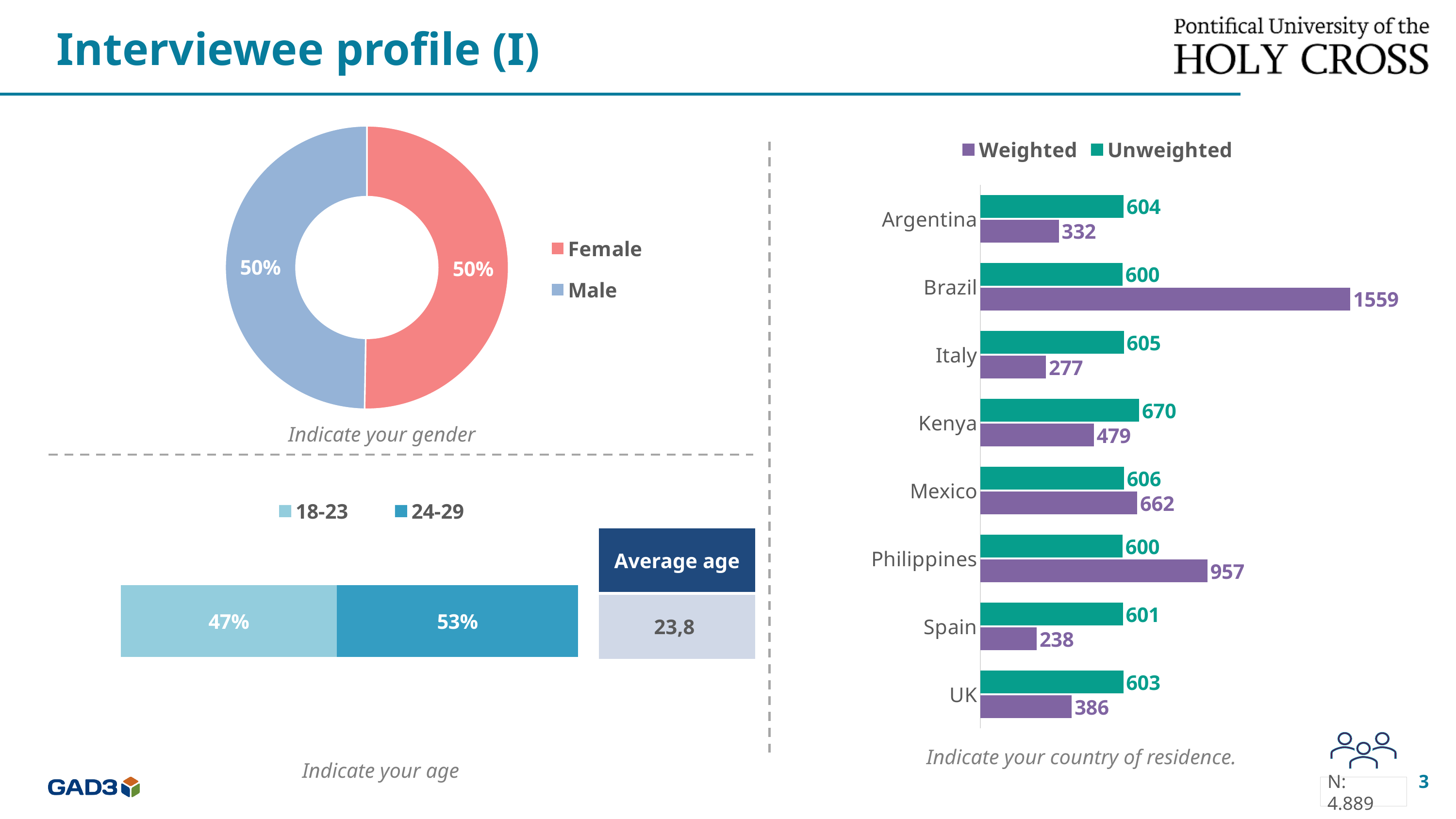
In the 'Indicate your age' chart, what is the total of the two age groups in the stacked bar? 100% In the 'Indicate your age' chart, what is the value for the 24-29 group? 53% In the country of residence chart, is the Weighted value for Mexico larger or smaller than its Unweighted value? larger In the country of residence chart, what is the Weighted value for Brazil? 1559 In the country of residence chart, how many series does the legend list? 2 In the country of residence chart, what is the difference between the Unweighted and Weighted values for Argentina? 272 In the country of residence chart, which country has the lowest Weighted value? Spain In the 'Indicate your gender' chart, what share is Female? 50% In the country of residence chart, how many countries are shown? 8 What kind of chart is the 'Indicate your gender' chart? Doughnut chart In the country of residence chart, what is the Unweighted value for Kenya? 670 In the country of residence chart, which country has the highest Weighted value? Brazil